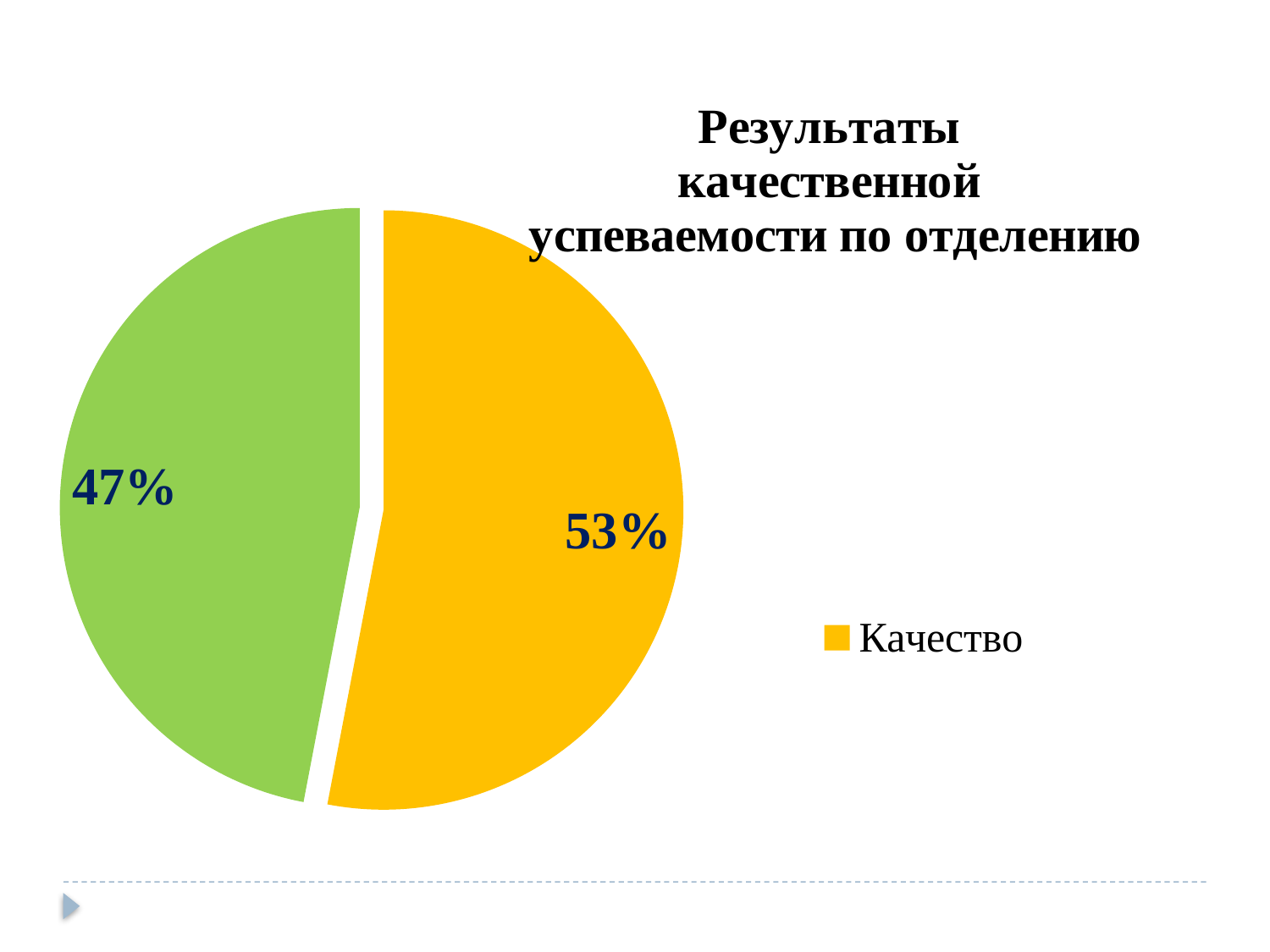
Which slice is the largest in the pie chart? Качество (53%) What is the value of the smallest slice in the pie chart? 47% What is the title of the chart? Результаты качественной успеваемости по отделению What is the value shown for the Качество slice? 53% What share of the pie does the Качество slice represent? 53% What is the value shown on the green slice of the pie? 47% How many entries does the legend list? 1 What kind of chart is shown on the slide? Pie chart Which is larger, the yellow slice or the green slice? The yellow slice What is the difference between the yellow slice and the green slice? 6 percentage points What colour is the Качество slice in the pie chart? Yellow How many slices does the pie chart have? 2